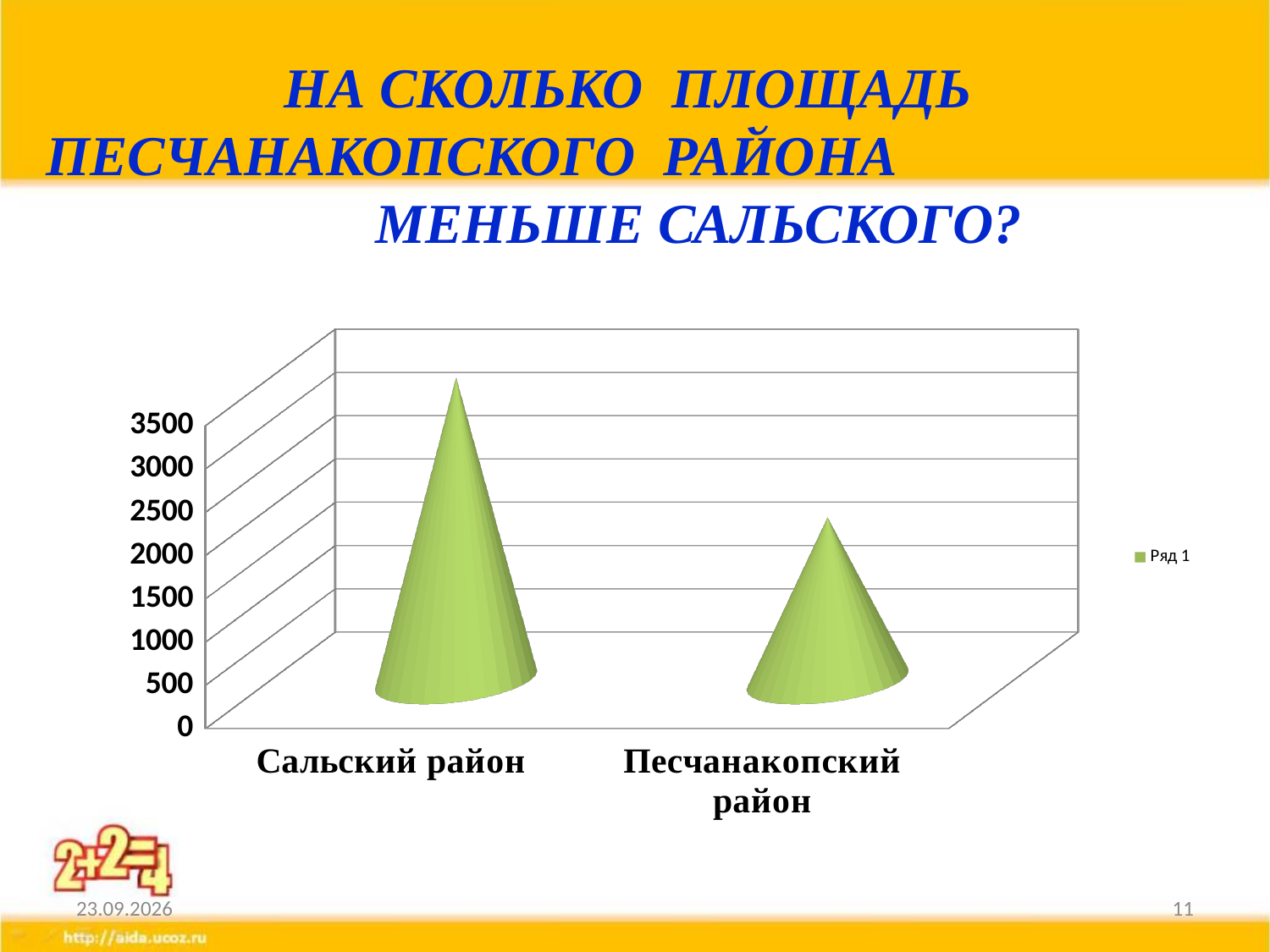
What kind of chart is shown on the slide? bar chart What is the highest value shown on the vertical axis of the chart? 3500 Which is larger, the value for Сальский район or the value for Песчанакопский район? Сальский район Is the value for Сальский район greater or less than 2500? greater How many categories are shown on the x axis of the chart? 2 How many series does the chart legend list? 1 Which category has the lowest value in the chart? Песчанакопский район Is the value for Песчанакопский район greater or less than 1500? greater What is the name of the series shown in the chart legend? Ряд 1 Is the value for Сальский район greater or less than 3000? greater Which category has the highest value in the chart? Сальский район